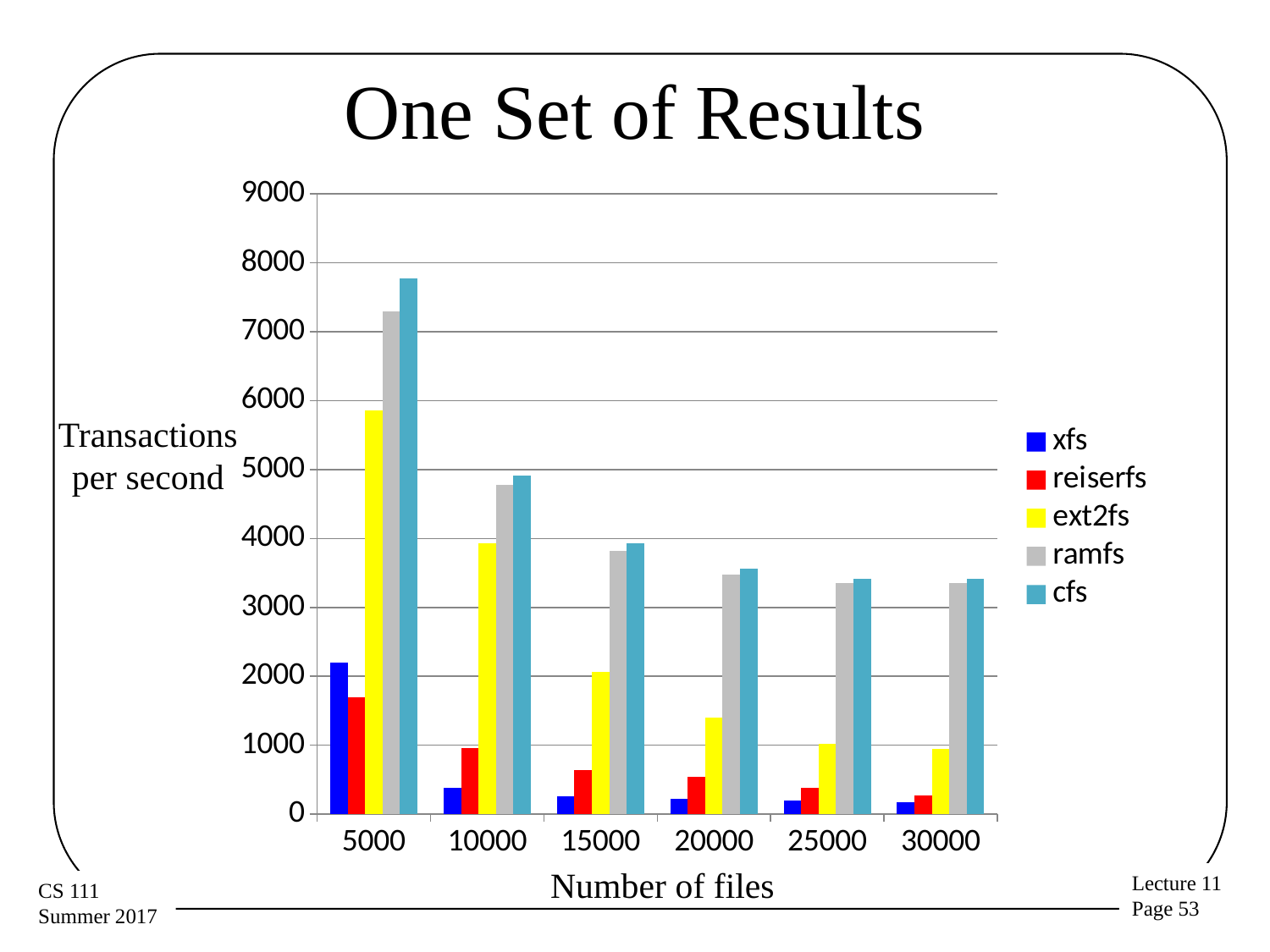
At 15000 files, which is larger: ext2fs or reiserfs? ext2fs What kind of chart is shown on the slide? bar chart What is the label on the y axis of the chart? Transactions per second Do the cfs values rise or fall as the number of files increases? fall How many series does the legend list? 5 Is the value for ext2fs at 20000 files greater or less than 2000? less Is the value for cfs at 5000 files greater or less than 7000? greater How many number-of-files categories are shown on the x axis? 6 Which file system has the highest transactions per second at 5000 files? cfs Is the value for ext2fs at 5000 files greater or less than 5000? greater Which file system has the lowest transactions per second at 5000 files? reiserfs